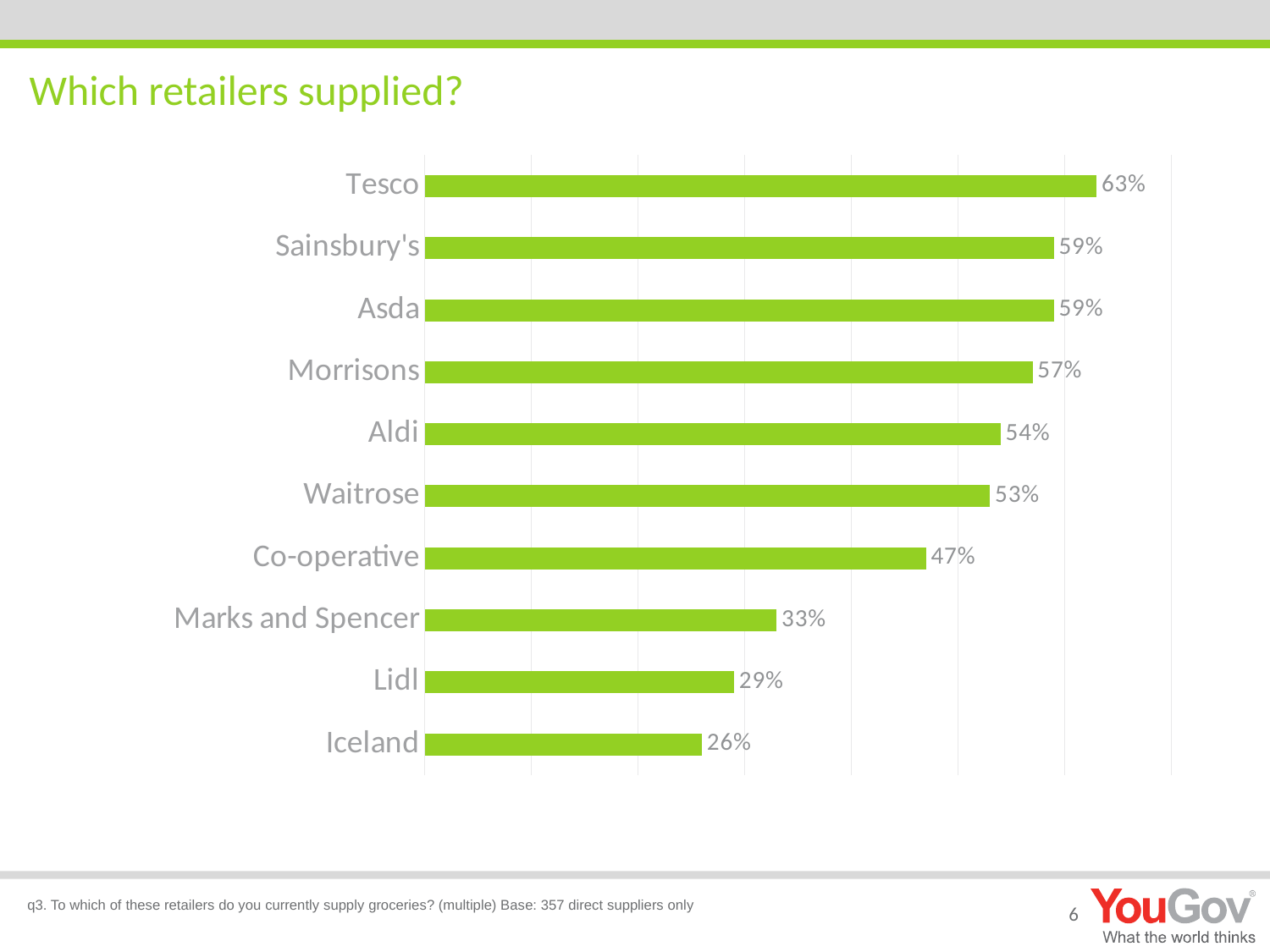
Which retailer has the highest value? Tesco What is the value for Tesco? 63% Which is larger, the value for Aldi or the value for Waitrose? Aldi What is the title of the slide? Which retailers supplied? What kind of chart is shown on the slide? Bar chart How many retailers are shown in the chart? 10 What is the difference between the values for Morrisons and Marks and Spencer? 24% What is the value for Co-operative? 47% Which retailer has the lowest value? Iceland What is the value for Lidl? 29% What is the difference between the values for Tesco and Iceland? 37% Which is larger, the value for Marks and Spencer or the value for Lidl? Marks and Spencer